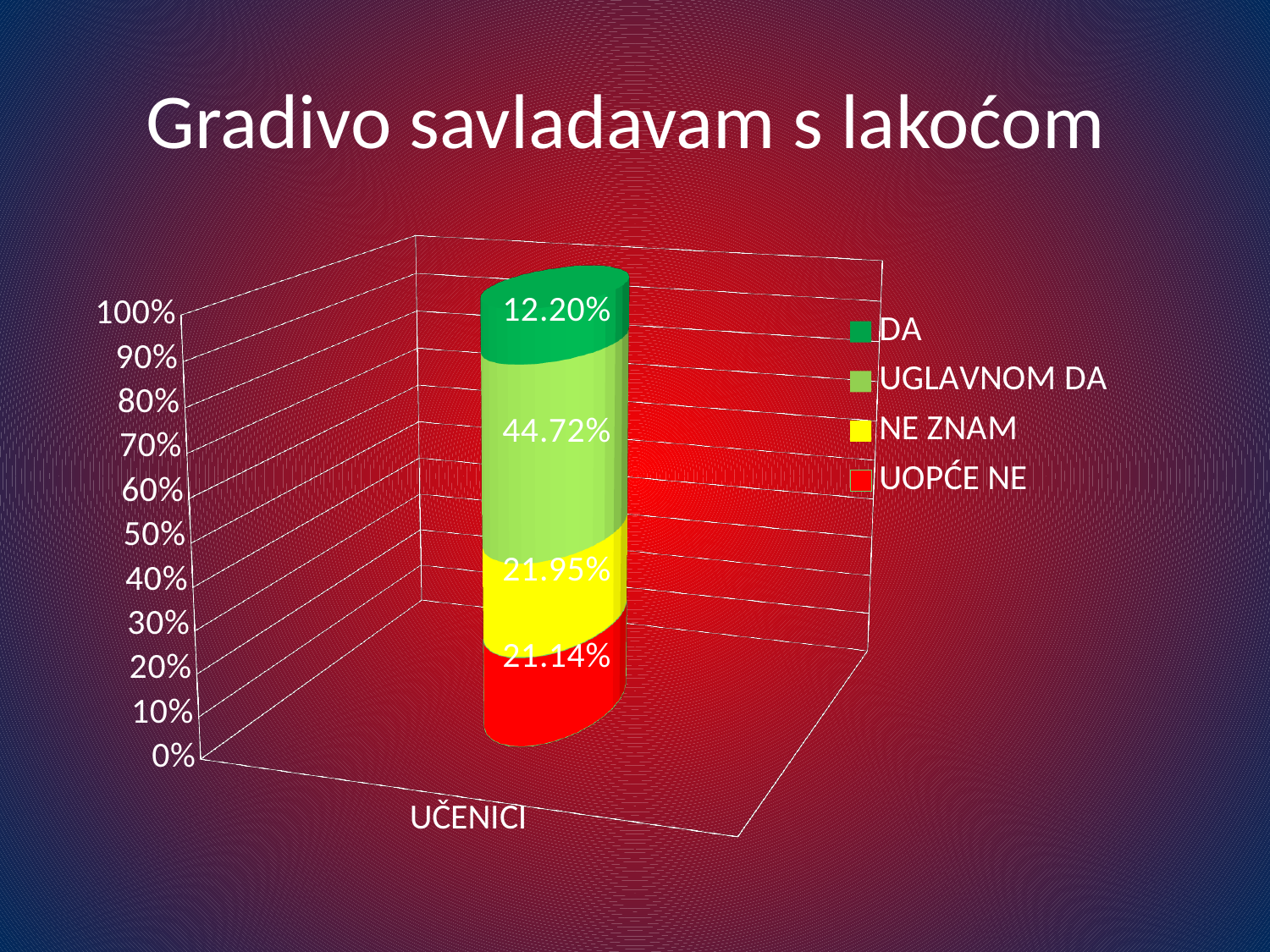
What is the value for NE ZNAM? 21.95% Which series has the highest value? UGLAVNOM DA What type of chart is shown on the slide? bar chart What is the value for UOPĆE NE? 21.14% What is the difference between the values for UGLAVNOM DA and DA? 32.52% Which series has the lowest value? DA What is the title of the chart? Gradivo savladavam s lakoćom What is the value for DA? 12.20% How many categories are shown on the x axis? 1 What is the value for UGLAVNOM DA? 44.72% Which is larger, the value for NE ZNAM or the value for UOPĆE NE? NE ZNAM How many series does the legend list? 4